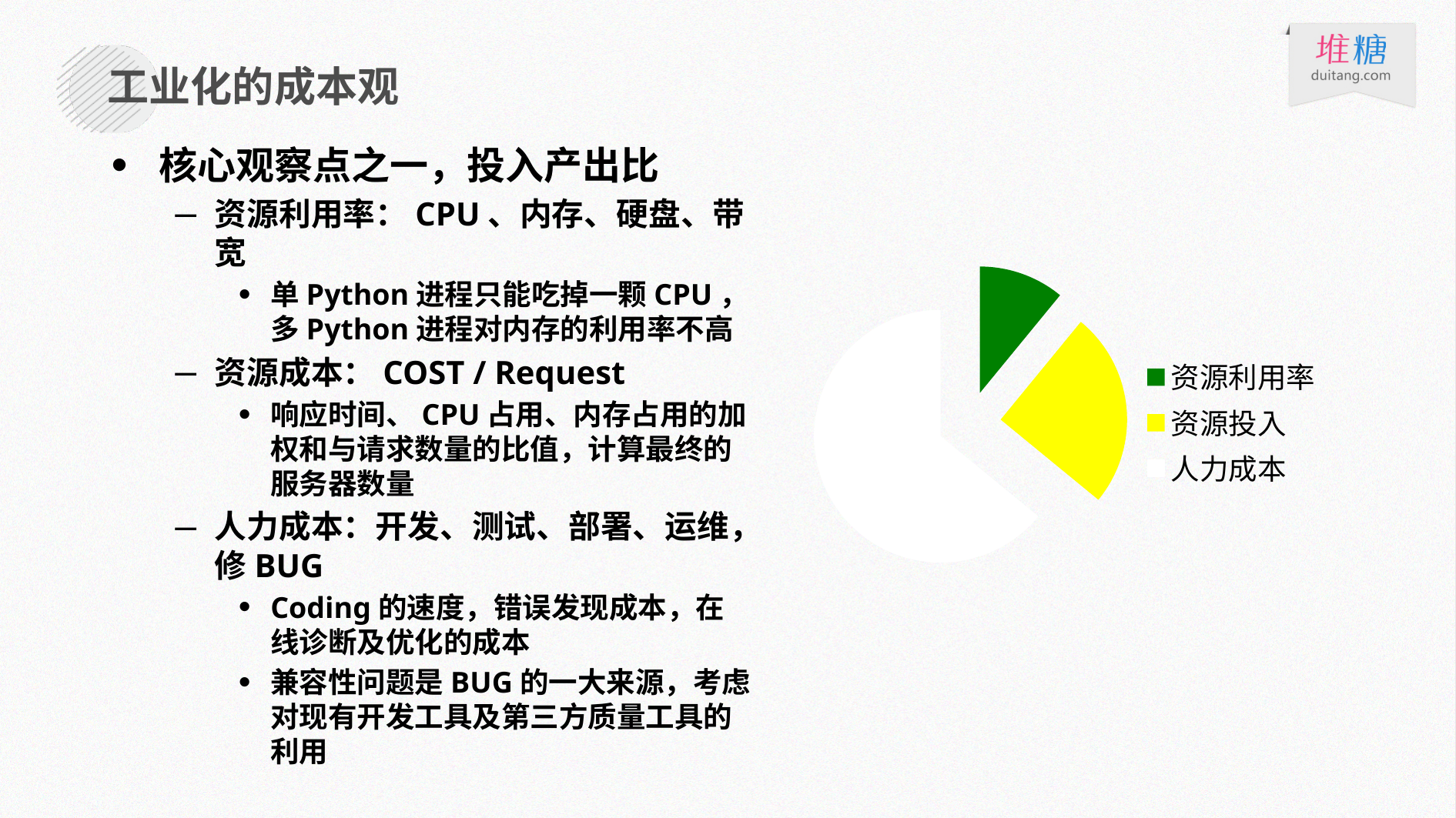
Which category has the largest slice in the pie chart? 人力成本 How many slices does the pie chart have? 3 In the pie chart, which slice is larger: 人力成本 or 资源投入? 人力成本 What kind of chart is shown on the right side of the slide? pie chart Which category has the smallest slice in the pie chart? 资源利用率 What colour is the 资源利用率 slice in the pie chart? green In the pie chart, which slice is larger: 资源投入 or 资源利用率? 资源投入 How many entries does the pie chart's legend list? 3 Which category is shown in yellow in the pie chart? 资源投入